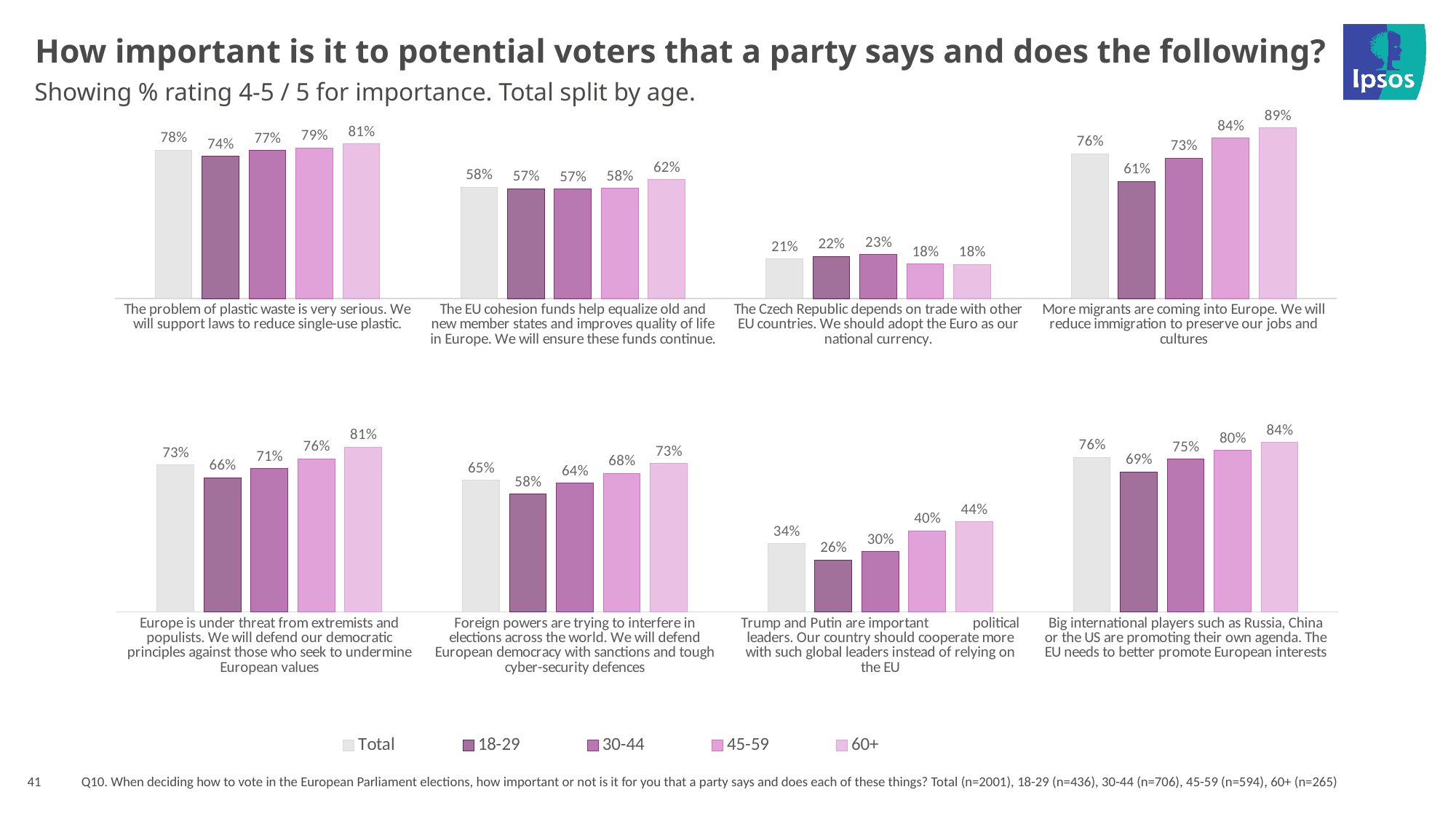
For the statement 'Foreign powers are trying to interfere in elections across the world. We will defend European democracy with sanctions and tough cyber-security defences', which is larger: the 30-44 value or the 45-59 value? 45-59 What is the 60+ value for the statement 'More migrants are coming into Europe. We will reduce immigration to preserve our jobs and cultures'? 89% What is the Total value for the statement 'The problem of plastic waste is very serious. We will support laws to reduce single-use plastic.'? 78% Which statement has the lowest Total value? The Czech Republic depends on trade with other EU countries. We should adopt the Euro as our national currency. What kind of chart is used on the slide? Bar chart Which series is shown in light grey in the legend? Total Which age group has the highest value for the statement 'Europe is under threat from extremists and populists. We will defend our democratic principles against those who seek to undermine European values'? 60+ What is the 18-29 value for the statement 'Trump and Putin are important political leaders. Our country should cooperate more with such global leaders instead of relying on the EU'? 26% For the statement 'Big international players such as Russia, China or the US are promoting their own agenda. The EU needs to better promote European interests', do the values rise or fall from the 18-29 group to the 60+ group? Rise How many series does the legend list? 5 How many statements are shown on the slide? 8 What is the difference between the 60+ and 18-29 values for the statement 'More migrants are coming into Europe. We will reduce immigration to preserve our jobs and cultures'? 28%